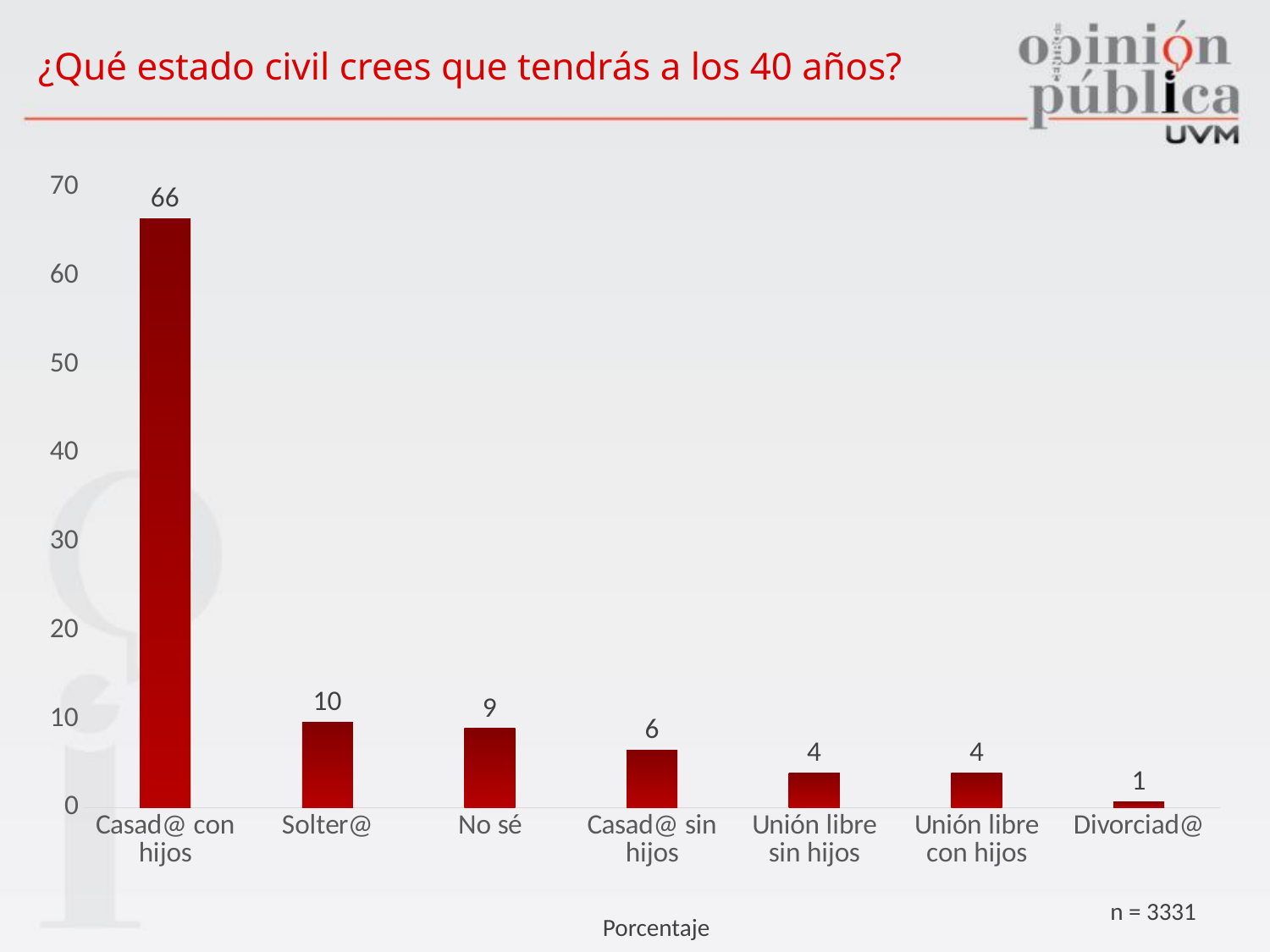
What is the difference between the values for "Casad@ sin hijos" and "Unión libre sin hijos"? 2 Which is larger, the value for "Solter@" or the value for "Casad@ sin hijos"? Solter@ Which category has the lowest value? Divorciad@ What is the value for "Casad@ con hijos"? 66 How many categories are shown on the x axis? 7 What is the sample size (n) shown on the slide? n = 3331 What kind of chart is shown on the slide? Bar chart What is the value for "Solter@"? 10 What is the difference between the values for "Casad@ con hijos" and "Solter@"? 56 What is the value for "Divorciad@"? 1 Which category has the highest value? Casad@ con hijos What is the value for "No sé"? 9